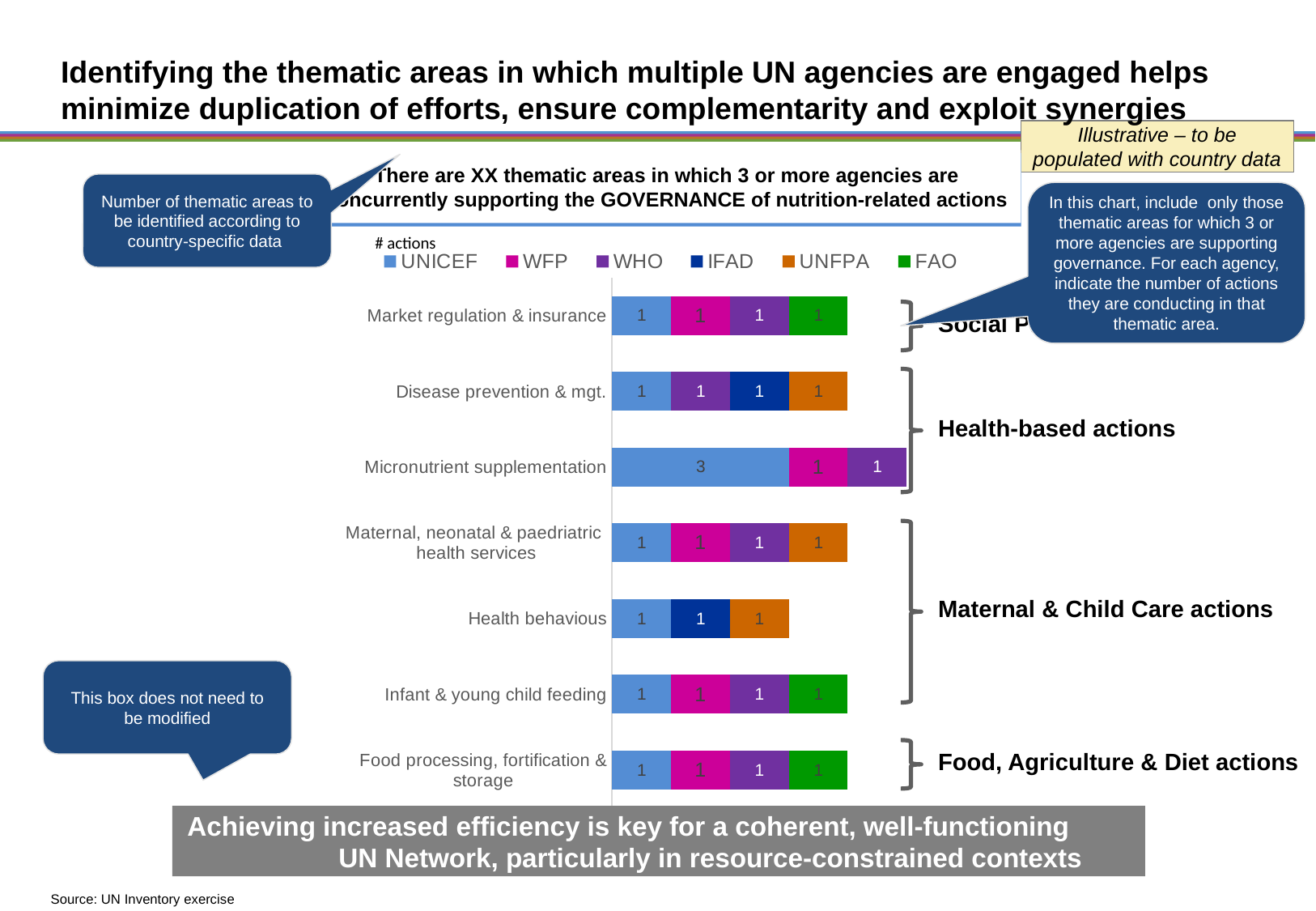
How many UNICEF actions are shown for Micronutrient supplementation? 3 How many series does the chart legend list? 6 Which has more UNICEF actions: Micronutrient supplementation or Infant & young child feeding? Micronutrient supplementation What is the total number of actions in the Health behavious bar? 3 Which agency is listed first in the chart legend? UNICEF Which thematic area has the lowest total number of actions? Health behavious What is the difference between the total actions for Micronutrient supplementation and Health behavious? 2 What kind of chart is shown on the slide? Stacked bar chart How many IFAD actions are shown for Disease prevention & mgt.? 1 Which thematic area has the highest total number of actions? Micronutrient supplementation What is the total number of actions in the Micronutrient supplementation bar? 5 How many thematic areas (categories) are plotted in the chart? 7